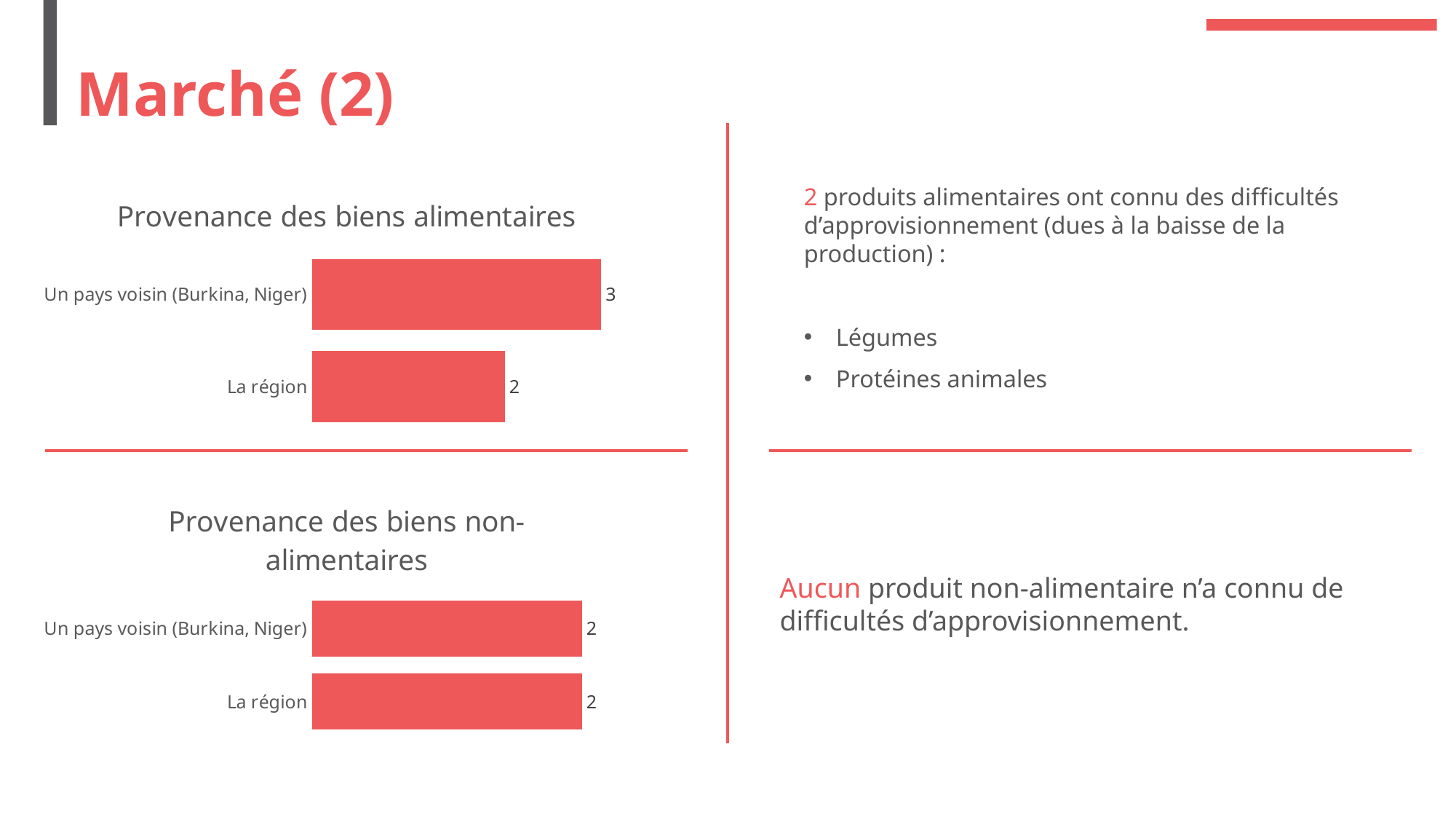
In the 'Provenance des biens non-alimentaires' chart, what is the value for 'Un pays voisin (Burkina, Niger)'? 2 In the 'Provenance des biens alimentaires' chart, what is the difference between the values for 'Un pays voisin (Burkina, Niger)' and 'La région'? 1 What kind of chart is the 'Provenance des biens non-alimentaires' chart? Bar chart In the 'Provenance des biens alimentaires' chart, what is the value for 'Un pays voisin (Burkina, Niger)'? 3 In the 'Provenance des biens alimentaires' chart, which category has the lowest value? La région In the 'Provenance des biens non-alimentaires' chart, what is the value for 'La région'? 2 What is the title of the top chart on the slide? Provenance des biens alimentaires In the 'Provenance des biens alimentaires' chart, which category has the highest value? Un pays voisin (Burkina, Niger) In the 'Provenance des biens alimentaires' chart, what is the value for 'La région'? 2 In the 'Provenance des biens non-alimentaires' chart, what is the difference between the values for 'Un pays voisin (Burkina, Niger)' and 'La région'? 0 How many categories does the 'Provenance des biens alimentaires' chart show? 2 In the 'Provenance des biens alimentaires' chart, which is larger: the value for 'Un pays voisin (Burkina, Niger)' or for 'La région'? Un pays voisin (Burkina, Niger)